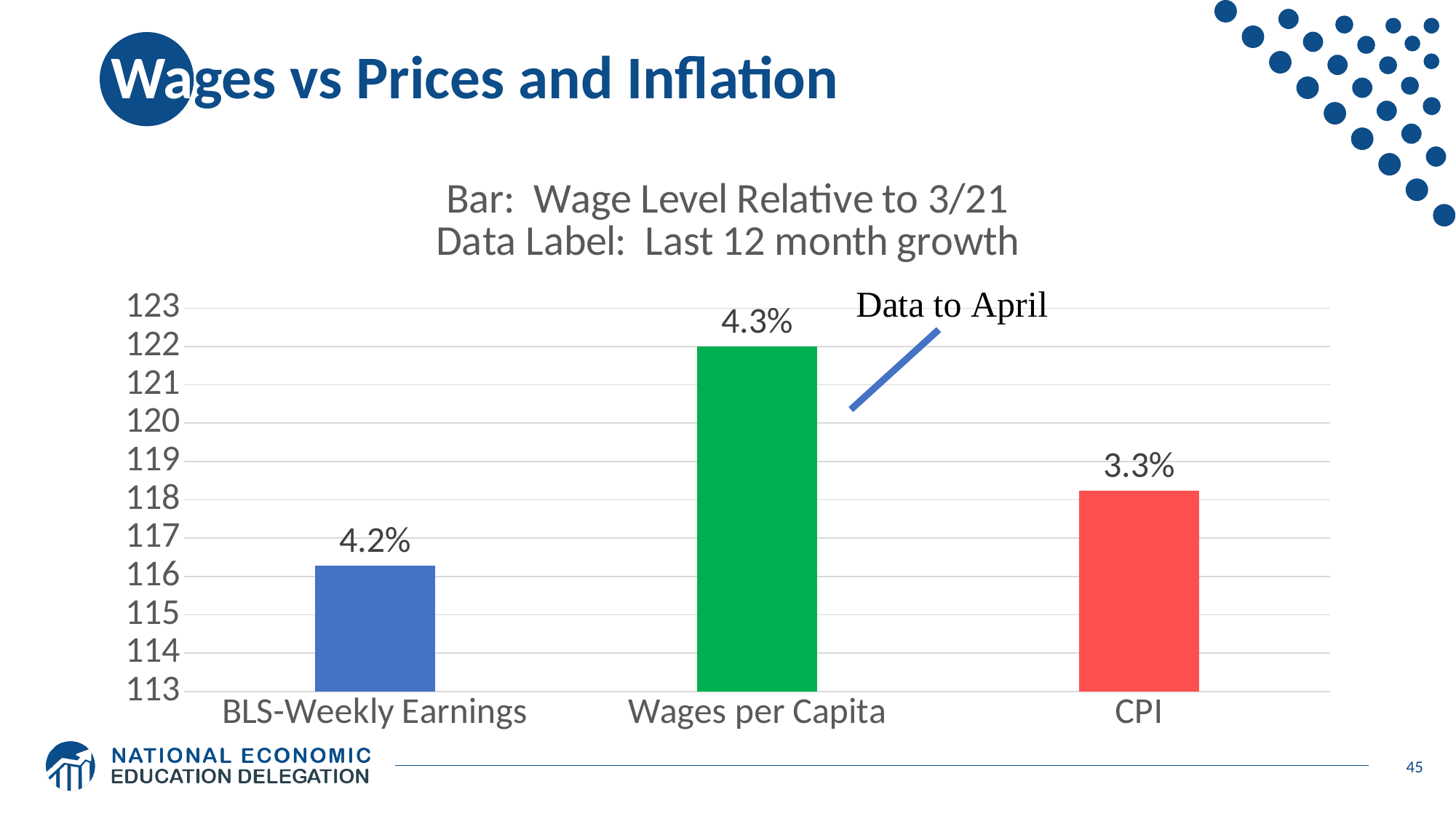
What is the data label shown on the Wages per Capita bar? 4.3% Which category has the lowest last-12-month growth data label? CPI Which category has the shortest bar? BLS-Weekly Earnings Is the bar height for BLS-Weekly Earnings greater or less than 117? less What is the data label shown on the BLS-Weekly Earnings bar? 4.2% Which category has the tallest bar? Wages per Capita Is the bar height for CPI greater or less than 118? greater How many categories are shown on the x axis? 3 Is the bar for Wages per Capita taller than the bar for CPI? Yes What kind of chart is shown on the slide? Bar chart What is the difference between the data labels for Wages per Capita and CPI? 1.0% What is the data label shown on the CPI bar? 3.3%